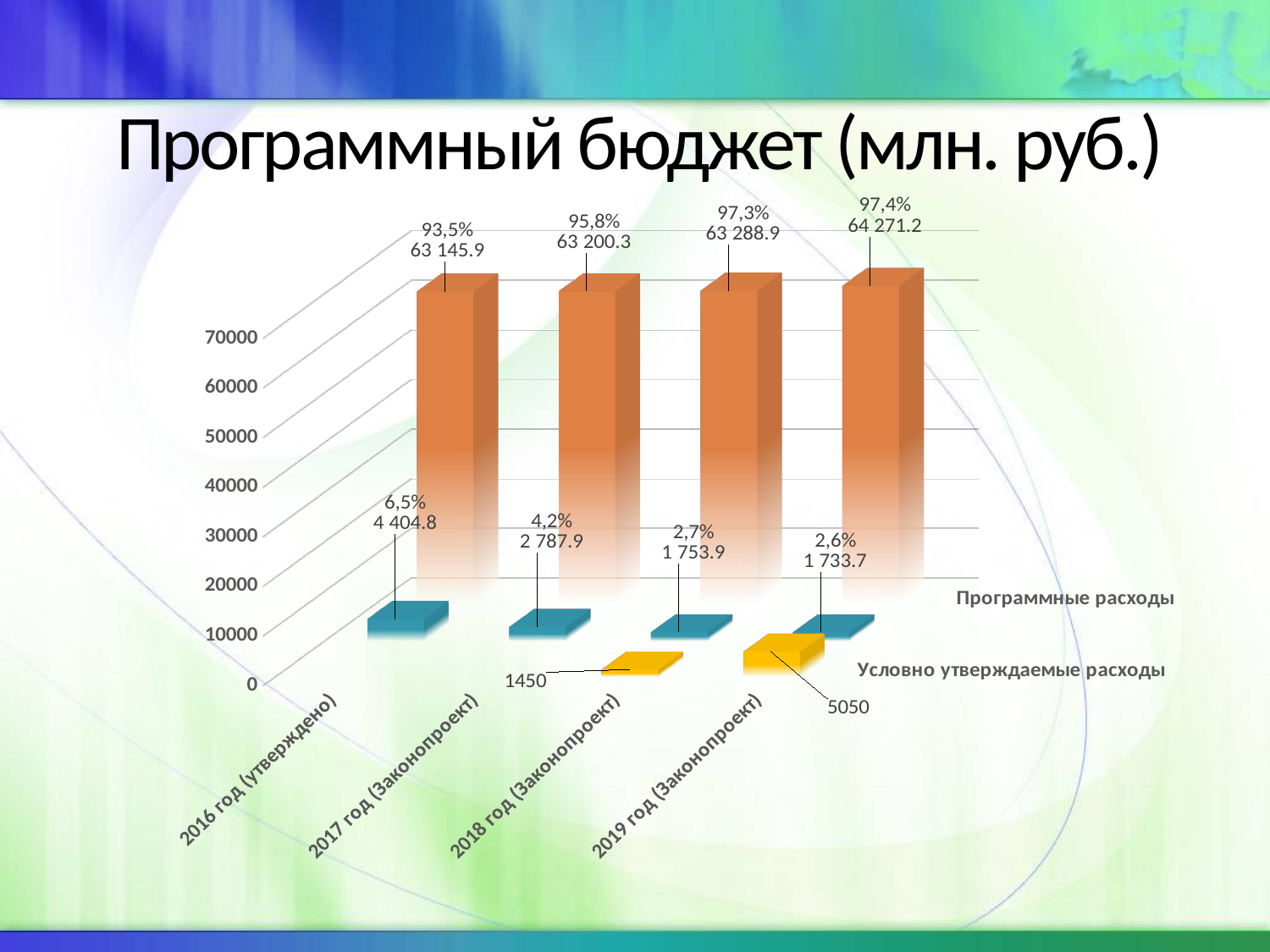
Do the orange bar values rise or fall from 2016 to 2019? Rise What is the value of the blue bar for 2017 год (Законопроект)? 2 787.9 Which category has the highest orange bar? 2019 год (Законопроект) What is the value of the orange bar for 2019 год (Законопроект)? 64 271.2 How many year categories are shown on the x axis? 4 What is the difference between the orange bar values for 2019 год (Законопроект) and 2018 год (Законопроект)? 982.3 Which category has the lowest blue bar? 2019 год (Законопроект) What is the difference between the blue bar values for 2016 год (утверждено) and 2017 год (Законопроект)? 1 616.9 What percentage is shown above the orange bar for 2016 год (утверждено)? 93,5% What kind of chart is shown on the slide? Bar chart What is the value of the yellow bar for 2018 год (Законопроект)? 1450 Which is larger: the yellow bar for 2018 год (Законопроект) or for 2019 год (Законопроект)? 2019 год (Законопроект)